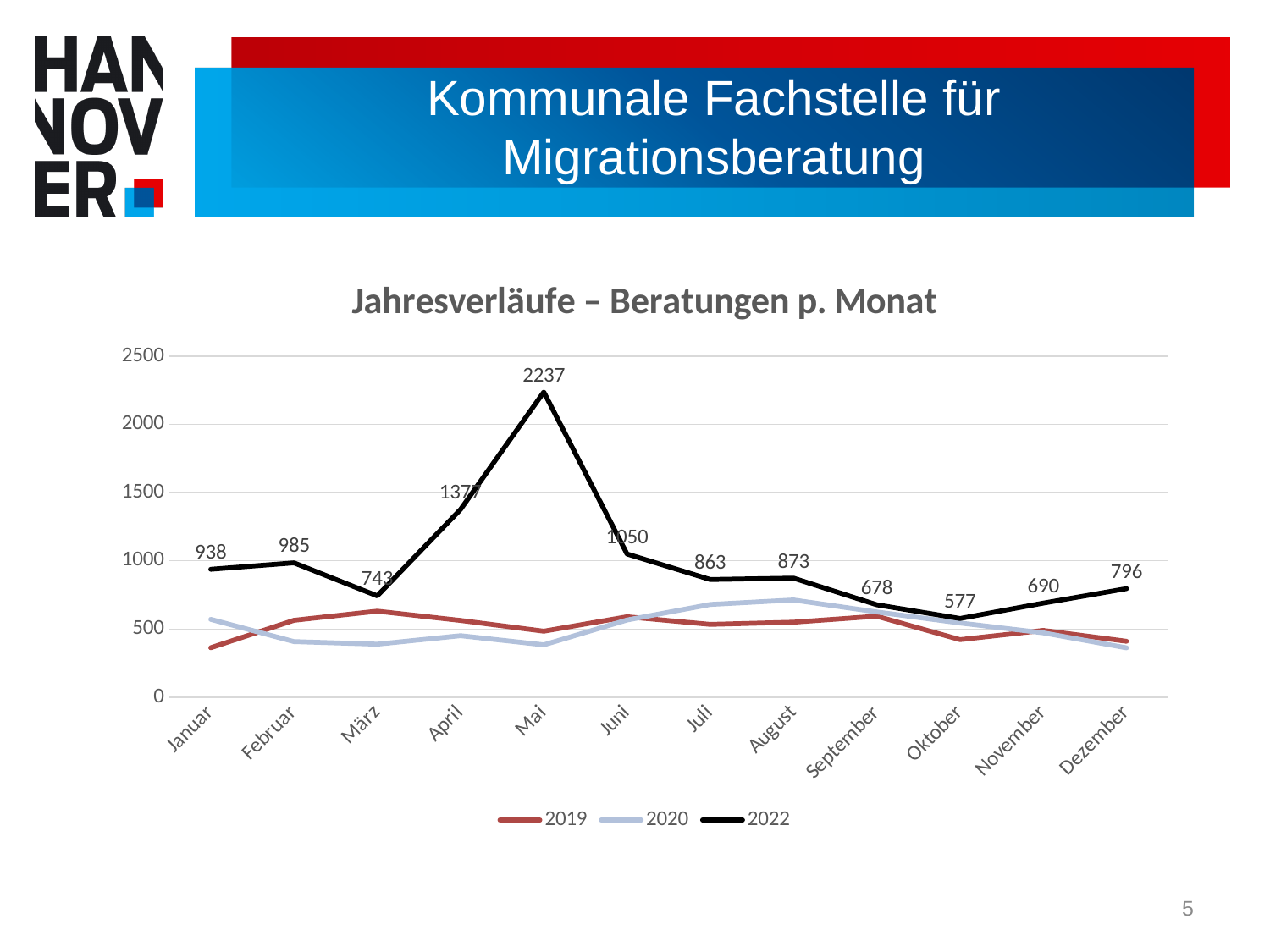
What is the value for 2022 in September? 678 Is the value for 2019 in Januar greater or less than 500? less What is the value for 2022 in Mai? 2237 How many months are plotted along the x axis? 12 What kind of chart is shown on the slide? line chart How many series does the legend list? 3 For 2022, which is larger: the value for Januar or the value for Dezember? Januar What is the difference between the 2022 values for Dezember and November? 106 In which month does the 2022 series reach its highest value? Mai What is the difference between the 2022 values for Februar and Januar? 47 In which month does the 2022 series have its lowest value? Oktober Does the 2022 series rise or fall from Mai to Oktober? fall